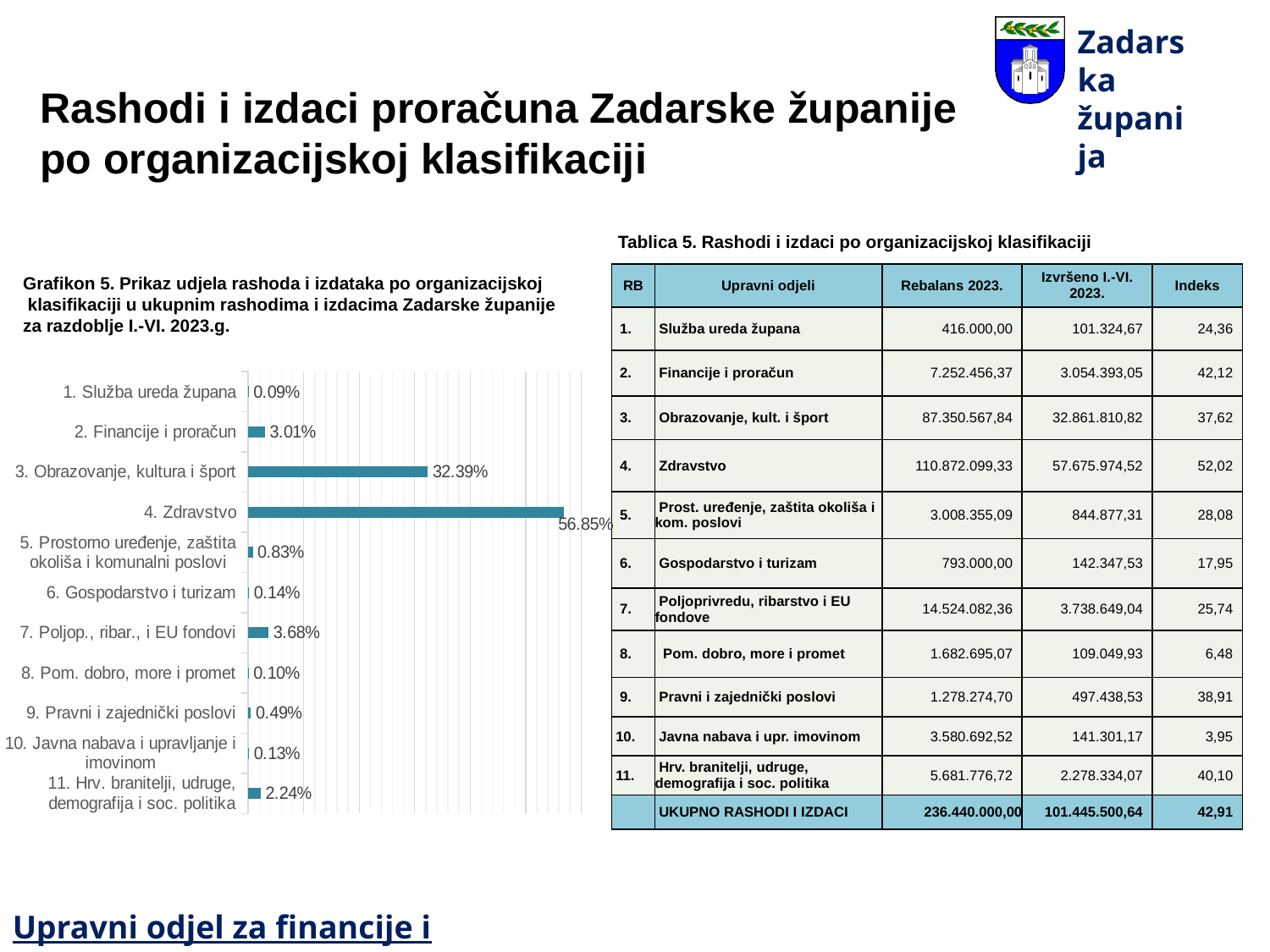
Which category has the highest value? 4. Zdravstvo What is the difference between the values for 4. Zdravstvo and 3. Obrazovanje, kultura i šport? 24.46% What is the value for 3. Obrazovanje, kultura i šport? 32.39% What is the value for 9. Pravni i zajednički poslovi? 0.49% What is the value for 7. Poljop., ribar., i EU fondovi? 3.68% What kind of chart is shown on the slide? bar chart Which is larger, the value for 7. Poljop., ribar., i EU fondovi or the value for 2. Financije i proračun? 7. Poljop., ribar., i EU fondovi What is the value for 4. Zdravstvo? 56.85% How many categories does the chart show? 11 What is the number of the chart (Grafikon) given in its title? Grafikon 5 Which category has the lowest value? 1. Služba ureda župana What is the value for 11. Hrv. branitelji, udruge, demografija i soc. politika? 2.24%